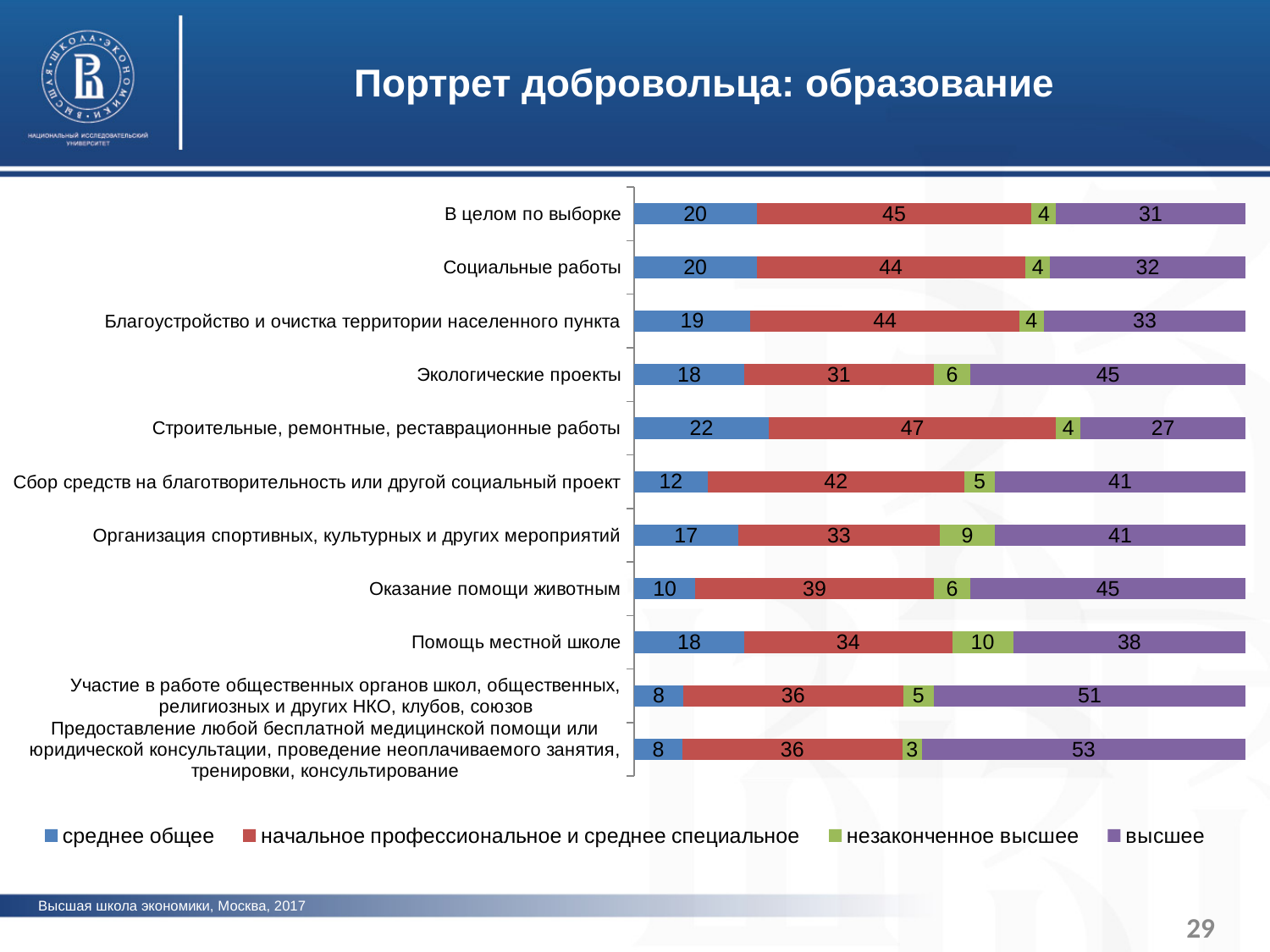
What kind of chart is shown on the slide? Stacked bar chart Which is larger: the «среднее общее» value for «Социальные работы» or for «Сбор средств на благотворительность или другой социальный проект»? Социальные работы What is the total of the stacked bar for «Экологические проекты»? 100 What is the value of «незаконченное высшее» for «Помощь местной школе»? 10 Which category has the lowest value for «незаконченное высшее»? Предоставление любой бесплатной медицинской помощи или юридической консультации, проведение неоплачиваемого занятия, тренировки, консультирование How many series does the legend list? 4 How many categories are shown in the chart? 11 What is the value of «начальное профессиональное и среднее специальное» for «В целом по выборке»? 45 Which category has the highest value for «высшее»? Предоставление любой бесплатной медицинской помощи или юридической консультации, проведение неоплачиваемого занятия, тренировки, консультирование What is the value of «высшее» for «Экологические проекты»? 45 What is the difference between the «высшее» values for «Оказание помощи животным» and «Строительные, ремонтные, реставрационные работы»? 18 What is the value of «среднее общее» for «Строительные, ремонтные, реставрационные работы»? 22